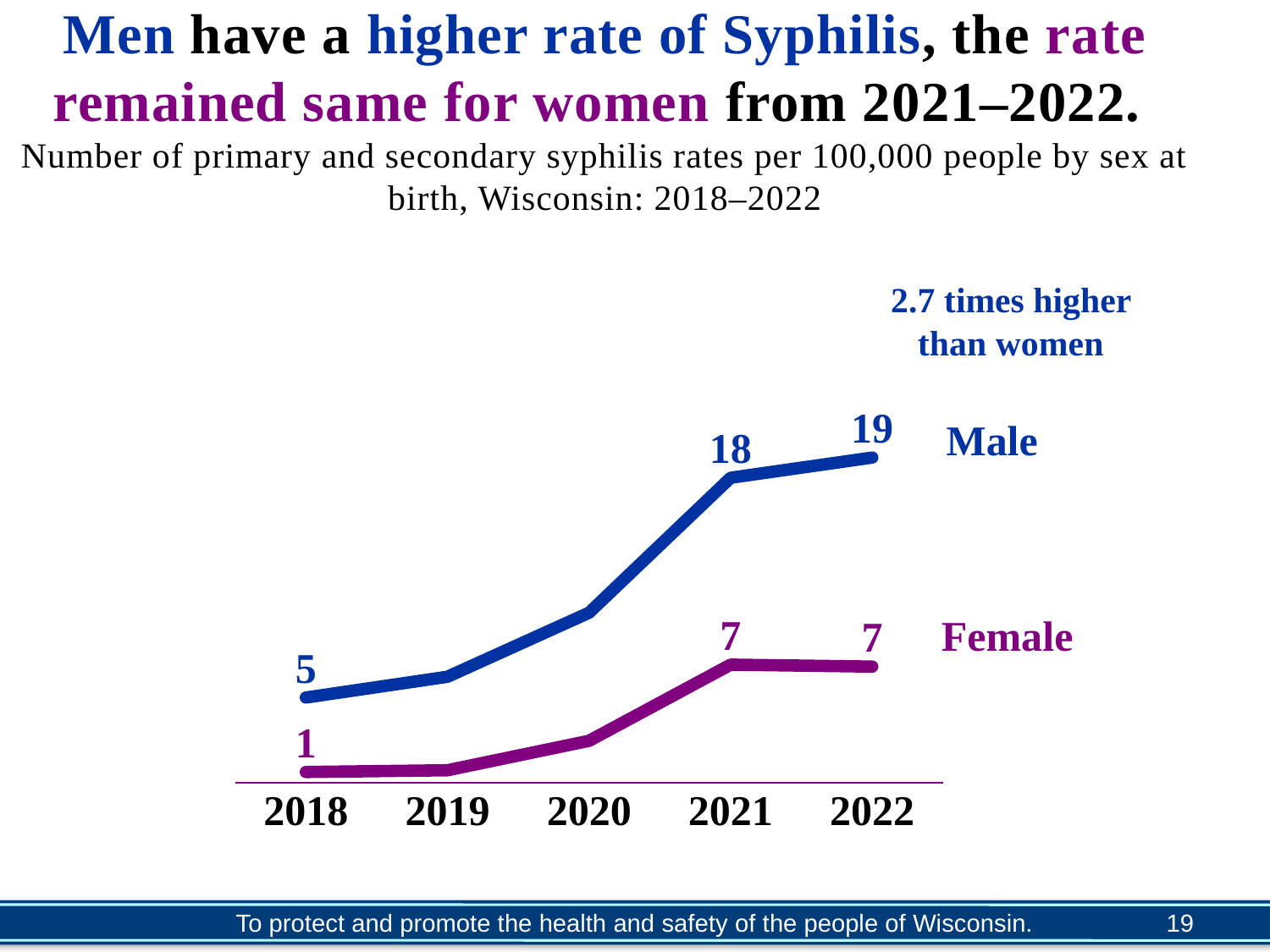
What was the male syphilis rate in 2022? 19 What type of chart is shown? Line chart What was the female syphilis rate in 2022? 7 In which year was the male rate highest? 2022 Which was higher in 2021, the male rate or the female rate? Male What was the female syphilis rate in 2018? 1 What was the male syphilis rate in 2021? 18 By how much did the male rate increase from 2018 to 2022? 14 How many years are shown on the x axis? 5 What is the difference between the male and female rates in 2022? 12 Does the male rate rise or fall from 2018 to 2022? Rise